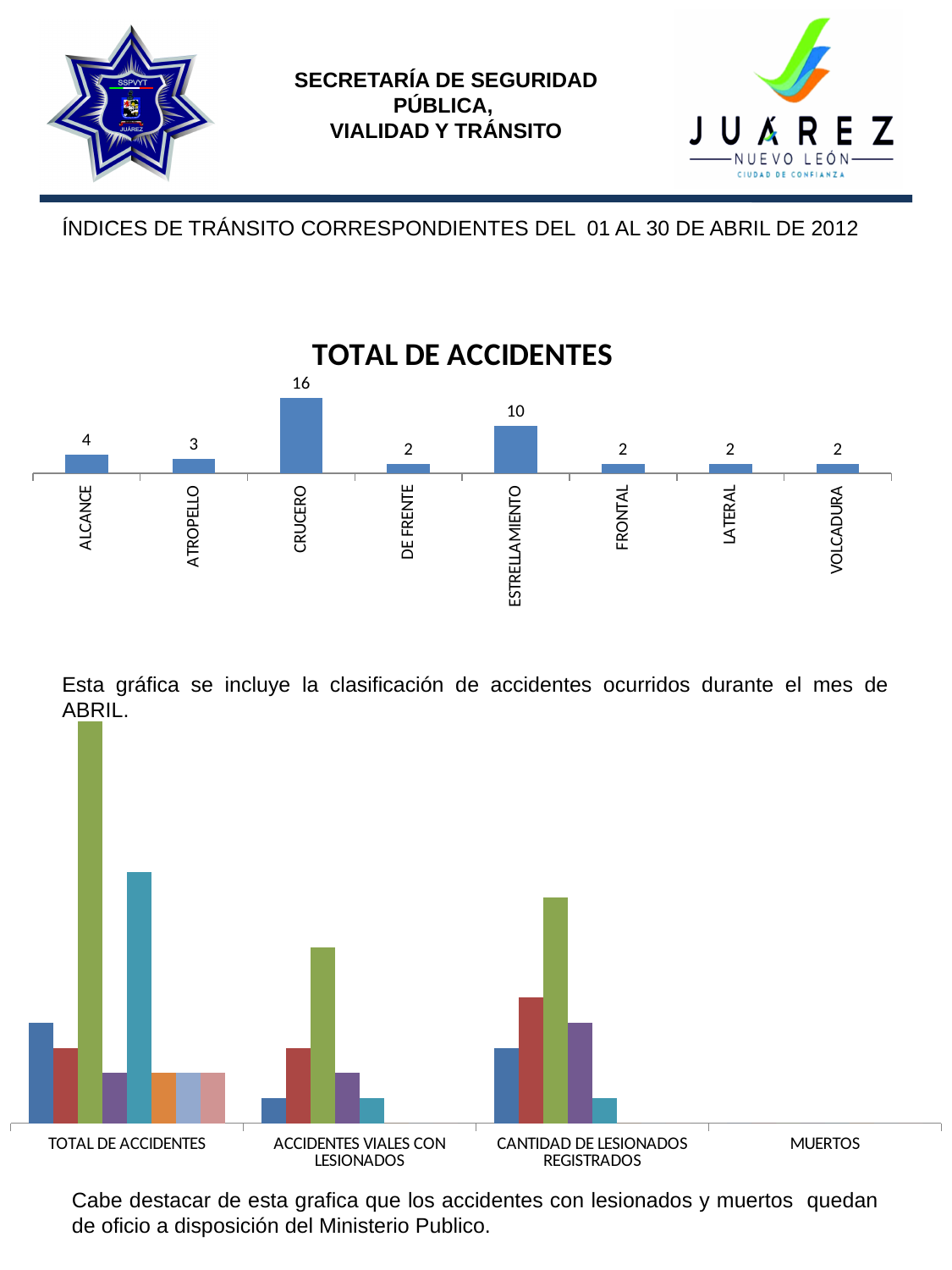
In the 'TOTAL DE ACCIDENTES' chart, what is the value for CRUCERO? 16 How many categories are shown on the x axis of the bottom chart? 4 In the 'TOTAL DE ACCIDENTES' chart, how many categories have a value of 2? 4 In the bottom chart, which category contains the tallest bar? TOTAL DE ACCIDENTES In the 'TOTAL DE ACCIDENTES' chart, which is larger, the value for ALCANCE or the value for ATROPELLO? ALCANCE In the 'TOTAL DE ACCIDENTES' chart, what is the difference between the values for CRUCERO and ESTRELLAMIENTO? 6 In the 'TOTAL DE ACCIDENTES' chart, what is the value for ATROPELLO? 3 What kind of chart is the 'TOTAL DE ACCIDENTES' chart? Bar chart In the 'TOTAL DE ACCIDENTES' chart, what is the value for ALCANCE? 4 In the 'TOTAL DE ACCIDENTES' chart, what is the value for ESTRELLAMIENTO? 10 In the 'TOTAL DE ACCIDENTES' chart, which category has the highest value? CRUCERO How many categories are shown in the 'TOTAL DE ACCIDENTES' chart? 8